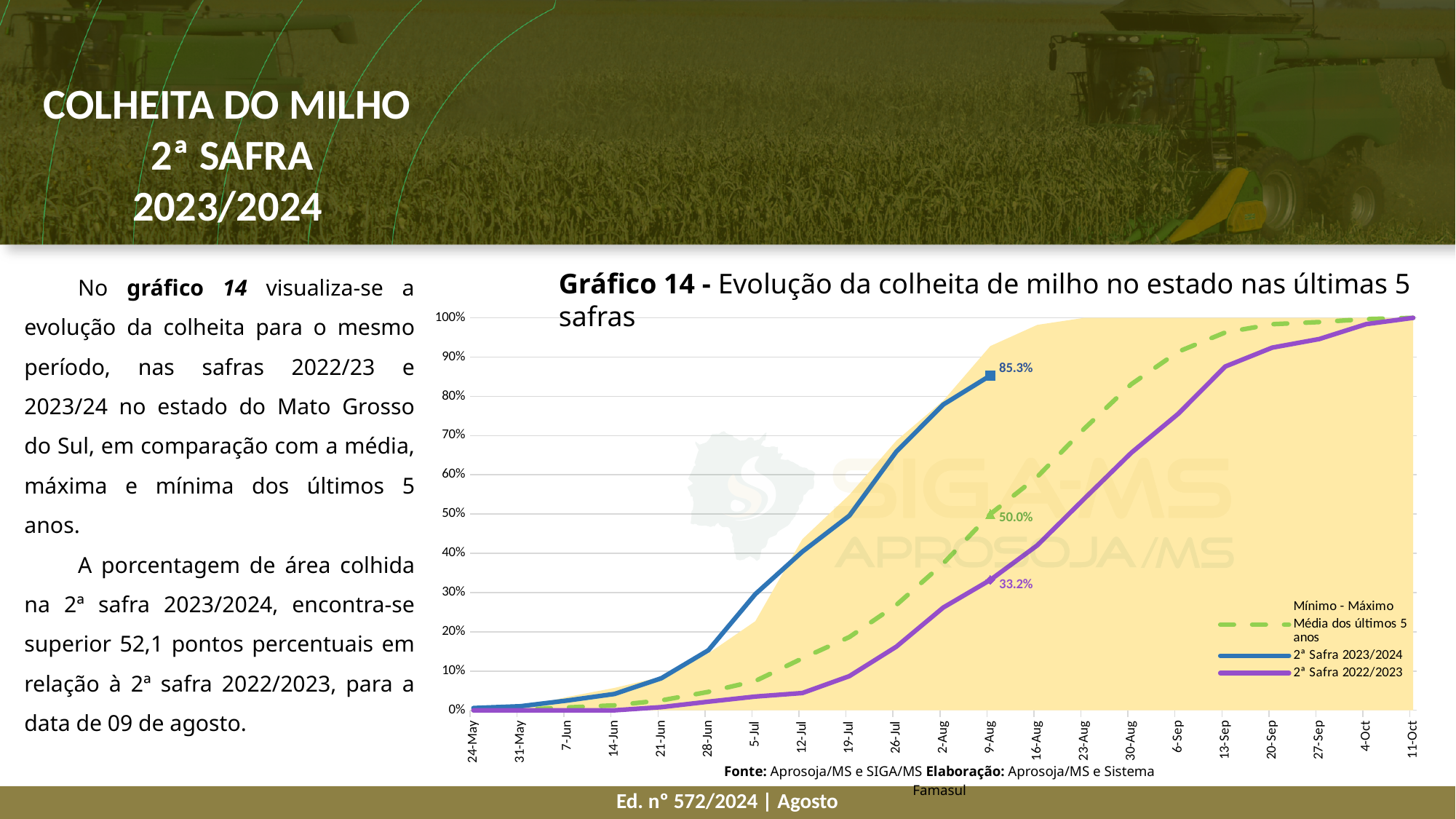
Is the value for 2ª Safra 2023/2024 on 28-Jun greater or less than 10%? greater What is the value for 2ª Safra 2023/2024 on 9-Aug? 85.3% What is the difference between the 2ª Safra 2023/2024 value and the Média dos últimos 5 anos value on 9-Aug? 35.3 percentage points Is the value for 2ª Safra 2022/2023 on 13-Sep greater or less than 80%? greater What is the difference between the 2ª Safra 2023/2024 and 2ª Safra 2022/2023 values on 9-Aug? 52.1 percentage points What is the value for Média dos últimos 5 anos on 9-Aug? 50.0% How many entries does the legend list? 4 On 9-Aug, which is larger: the 2ª Safra 2023/2024 value or the Média dos últimos 5 anos value? 2ª Safra 2023/2024 Do the values for 2ª Safra 2022/2023 rise or fall along the x axis? Rise What is the title of the chart? Gráfico 14 - Evolução da colheita de milho no estado nas últimas 5 safras What is the value for 2ª Safra 2022/2023 on 9-Aug? 33.2% What kind of chart is Gráfico 14? Combination area and line chart (lines over a shaded min–max area)